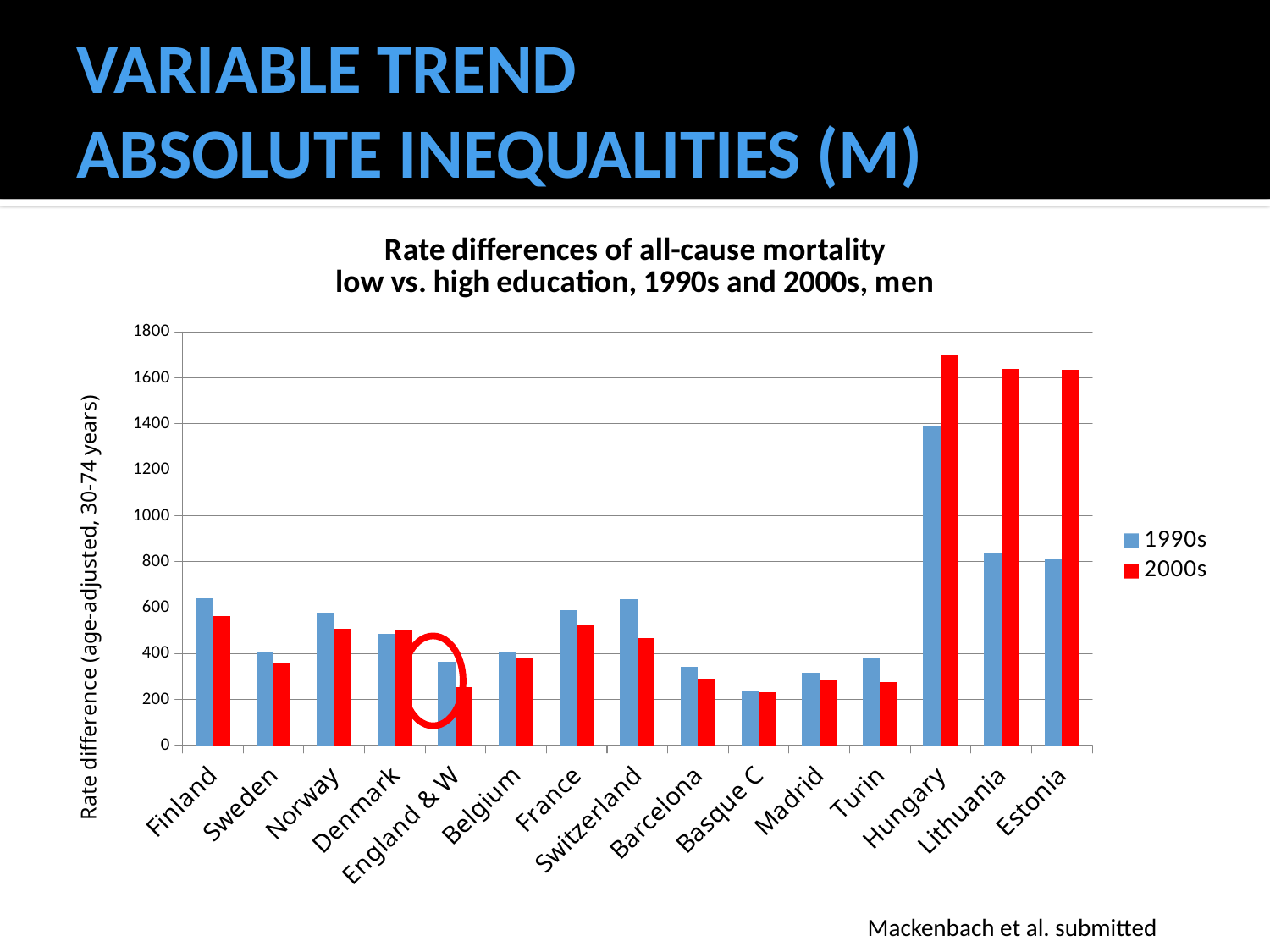
Which country or region has the lowest 1990s value? Basque C Which country has the highest 1990s value? Hungary For Finland, which is larger: the 1990s value or the 2000s value? 1990s Is the 2000s value for Estonia greater or less than 1400? greater What kind of chart is shown on the slide? bar chart Which country has the highest 2000s value? Hungary How many countries or regions are shown on the x axis? 15 Is the 1990s value for Hungary greater or less than 1200? greater For Hungary, which is larger: the 1990s value or the 2000s value? 2000s How many series does the legend list? 2 What is the title of the chart? Rate differences of all-cause mortality low vs. high education, 1990s and 2000s, men Is the 2000s value for England & W greater or less than 400? less